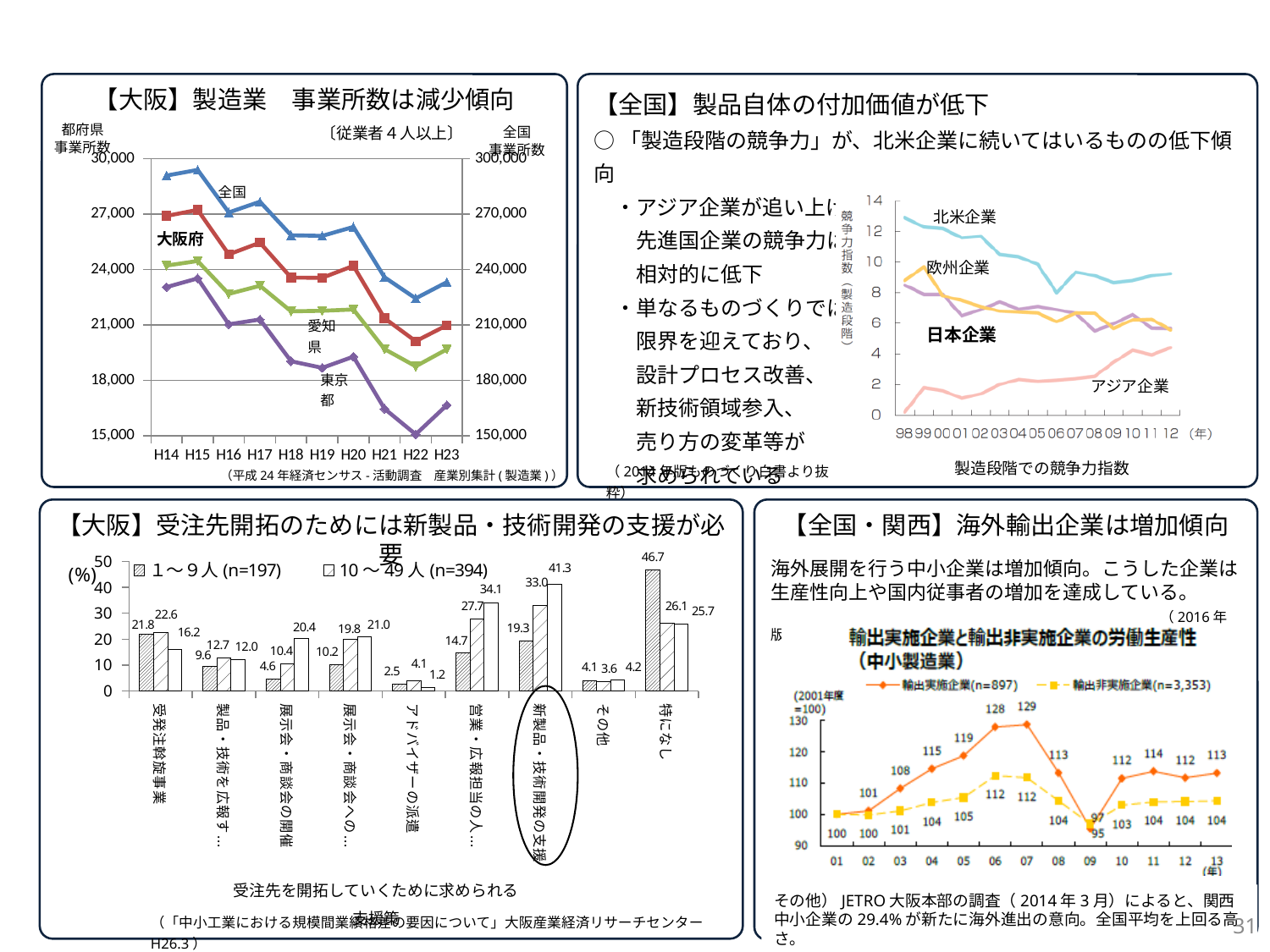
In the bottom-right chart titled 輸出実施企業と輸出非実施企業の労働生産性, what is the difference between 輸出実施企業 and 輸出非実施企業 in 07? 17 In the top-right chart titled 製造段階での競争力指数, is the value for 北米企業 in 98 greater or less than 12? greater In the bottom-left bar chart on 受注先を開拓していくために求められる支援策, what is the value for 特になし in the 1～9人 (n=197) series? 46.7 In the bottom-left bar chart on 受注先を開拓していくために求められる支援策, how many categories are shown on the x axis? 9 In the bottom-left bar chart on 受注先を開拓していくために求められる支援策, what is the value for 新製品・技術開発の支援 in the 1～9人 (n=197) series? 19.3 In the bottom-right chart titled 輸出実施企業と輸出非実施企業の労働生産性, what is the value for 輸出実施企業 in 07? 129 In the top-right chart titled 製造段階での競争力指数, which series has the highest values across the whole period? 北米企業 In the top-left chart titled 【大阪】製造業 事業所数は減少傾向, how many years are plotted along the x axis? 10 In the top-right chart titled 製造段階での競争力指数, which series has the lowest values across the whole period? アジア企業 In the top-left chart titled 【大阪】製造業 事業所数は減少傾向, is the value for 東京都 at H14 greater or less than 21,000? greater In the top-left chart titled 【大阪】製造業 事業所数は減少傾向, what kind of chart is it? line chart In the top-left chart titled 【大阪】製造業 事業所数は減少傾向, does the 大阪府 line rise or fall from H14 to H23? fall